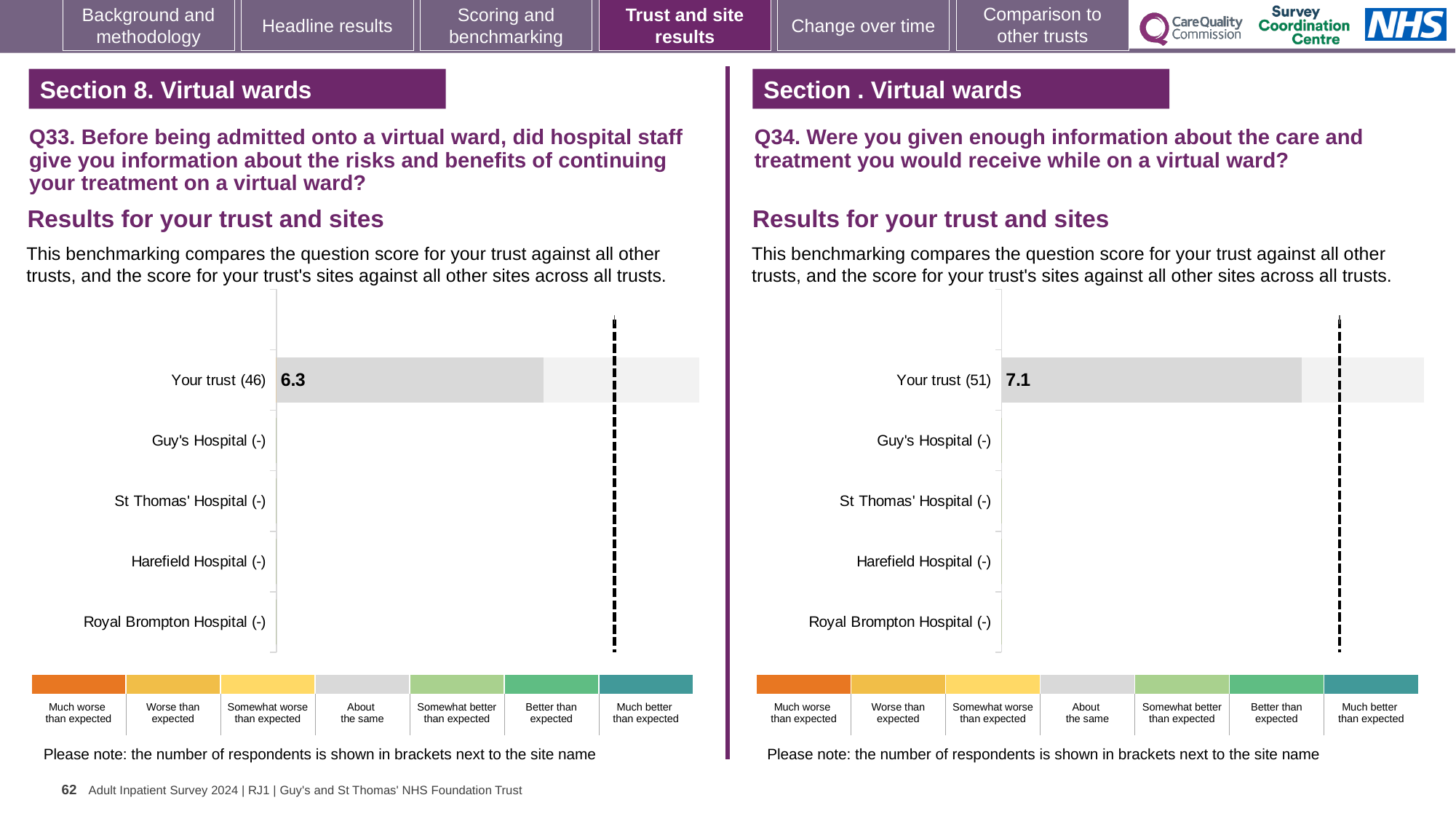
In the Q33 chart on the left, what is the score for Your trust? 6.3 What is the difference between the Your trust score in the Q34 chart and the Your trust score in the Q33 chart? 0.8 In the Q34 chart on the right, which category is listed last on the y axis? Royal Brompton Hospital (-) In the Q33 chart on the left, which category is the only one with a plotted bar? Your trust (46) In the Q33 chart on the left, how many respondents are shown in brackets next to Your trust? 46 How many site or trust categories are listed on the y axis of the Q34 chart on the right? 5 In the Q34 chart on the right, what is the score for Your trust? 7.1 Which chart shows a higher score for Your trust, the Q33 chart on the left or the Q34 chart on the right? Q34 chart on the right How many site or trust categories are listed on the y axis of the Q33 chart on the left? 5 How many benchmark bands are shown in the colour key below the Q34 chart on the right? 7 In the Q34 chart on the right, how many respondents are shown in brackets next to Your trust? 51 What type of chart is used in the Q33 chart on the left? Bar chart